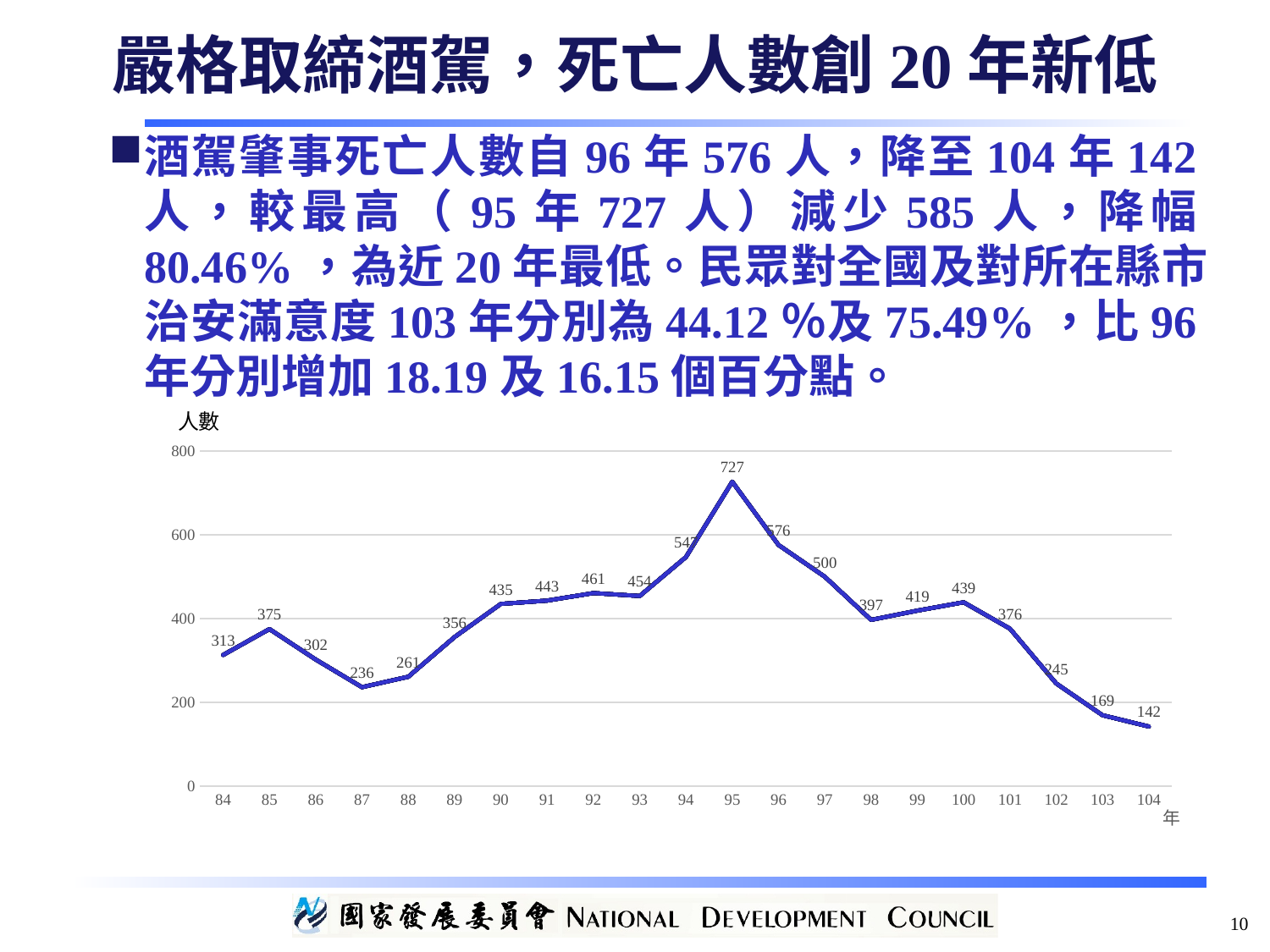
What is the value for year 104? 142 What is the difference between the values for year 95 and year 104? 585 Is the value for year 92 greater or less than 400? greater Which year has the highest value? 95 How many years are plotted on the x axis? 21 What is the value for year 95? 727 What type of chart is shown on the slide? line chart What is the value for year 87? 236 Which year has the lowest value? 104 Do the values rise or fall from year 95 to year 104? fall What is the value for year 100? 439 Which is larger, the value for year 96 or the value for year 97? 96